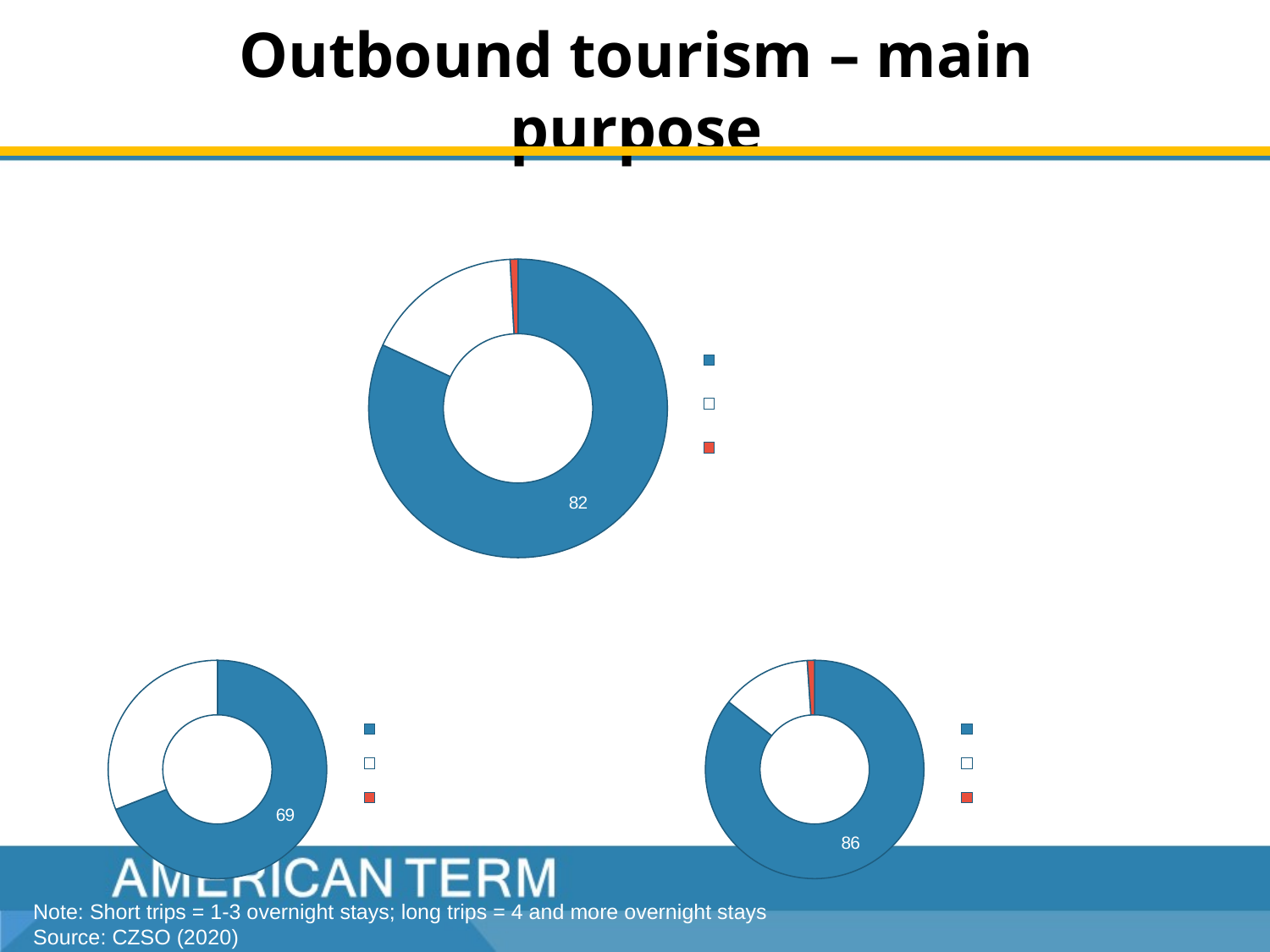
How many segments does the top doughnut chart have? 3 What is the difference between the blue segment value in the bottom-right chart and the blue segment value in the top chart? 4 In the bottom-left chart, what value is printed on the blue segment? 69 Which of the three charts shows the lowest printed value for its blue segment? the bottom-left chart What is the difference between the blue segment value in the bottom-right chart (86) and the blue segment value in the bottom-left chart (69)? 17 Is the blue segment value larger in the top chart or in the bottom-left chart? the top chart In the top chart, which colour is the largest segment? blue How many entries does the legend of the bottom-right chart list? 3 In the top chart, what value is printed on the blue segment? 82 What kind of chart is the top chart on the slide? doughnut chart Which of the three charts shows the highest printed value for its blue segment? the bottom-right chart In the bottom-right chart, what value is printed on the blue segment? 86